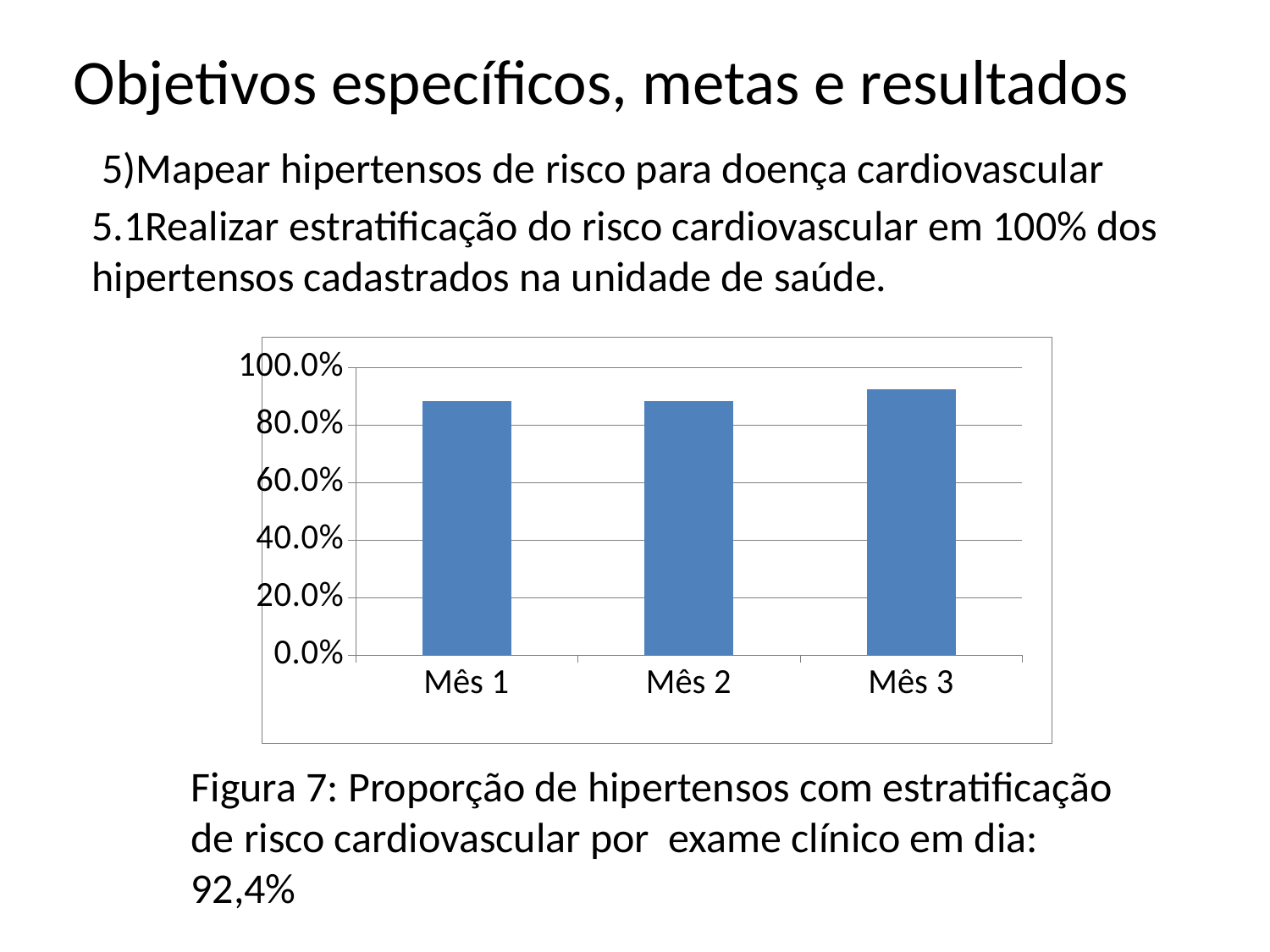
How many categories (months) are shown on the x axis of the chart? 3 Which is larger, the value for Mês 1 or the value for Mês 3? Mês 3 Is the value for Mês 3 greater or less than 80.0%? greater What is the label of the first category on the x axis? Mês 1 Is the value for Mês 2 greater or less than 100.0%? less What kind of chart is shown on the slide? bar chart Is the value for Mês 1 greater or less than 80.0%? greater Which month has the highest bar in the chart? Mês 3 What is the highest tick value shown on the y axis of the chart? 100.0% Does the value rise or fall from Mês 2 to Mês 3? rise